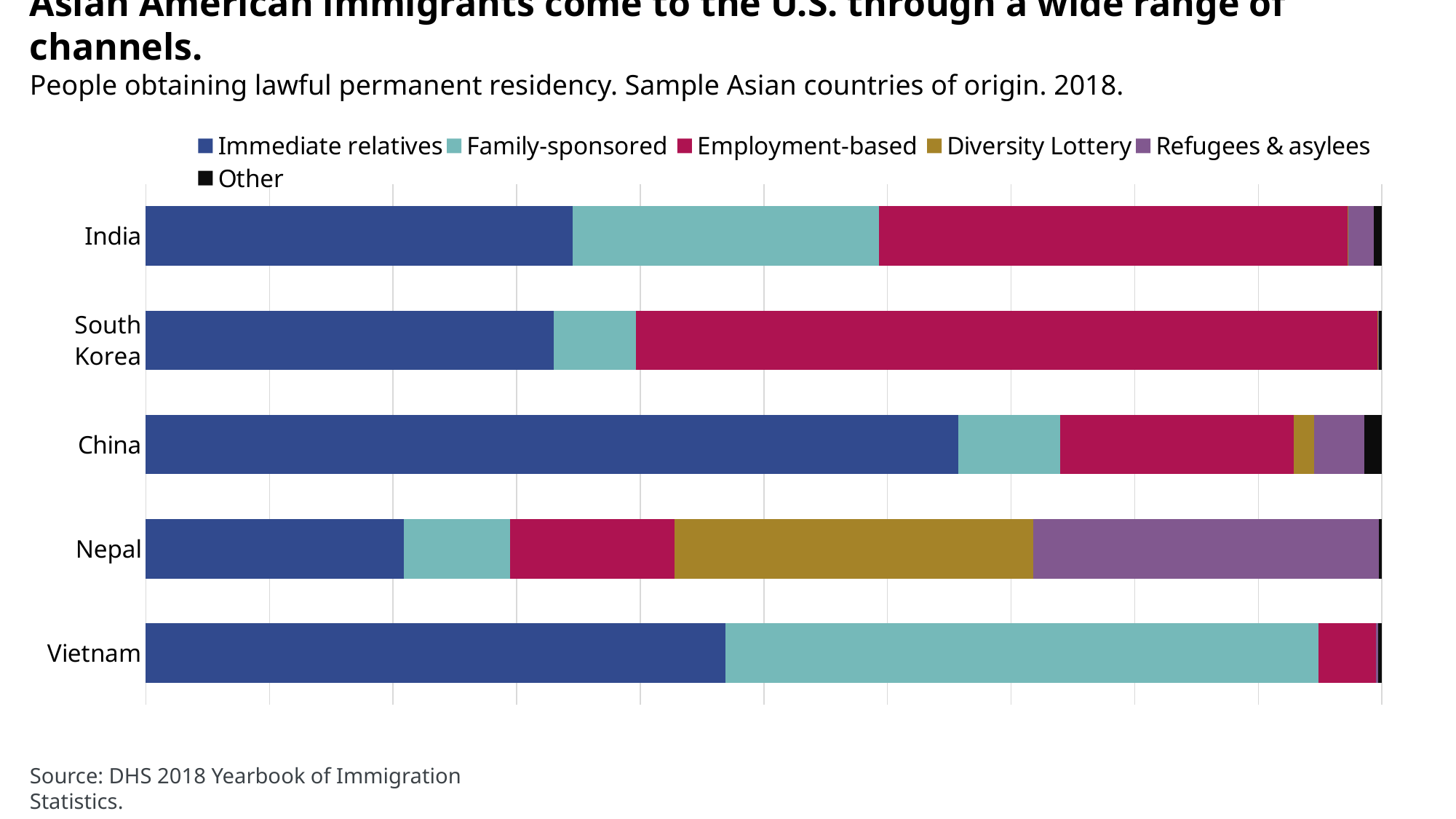
What kind of chart is shown on the slide? Stacked bar chart Which country has the largest Employment-based share of its bar? South Korea For India, which segment is larger: Family-sponsored or Employment-based? Employment-based Which country has the largest Family-sponsored share of its bar? Vietnam Which category is listed first in the legend? Immediate relatives How many countries of origin are shown in the chart? 5 Which country has the largest Immediate relatives share of its bar? China For China, which segment is larger: Immediate relatives or Employment-based? Immediate relatives For South Korea, which segment is larger: Immediate relatives or Employment-based? Employment-based Which country has the smallest Immediate relatives share of its bar? Nepal How many series does the legend list? 6